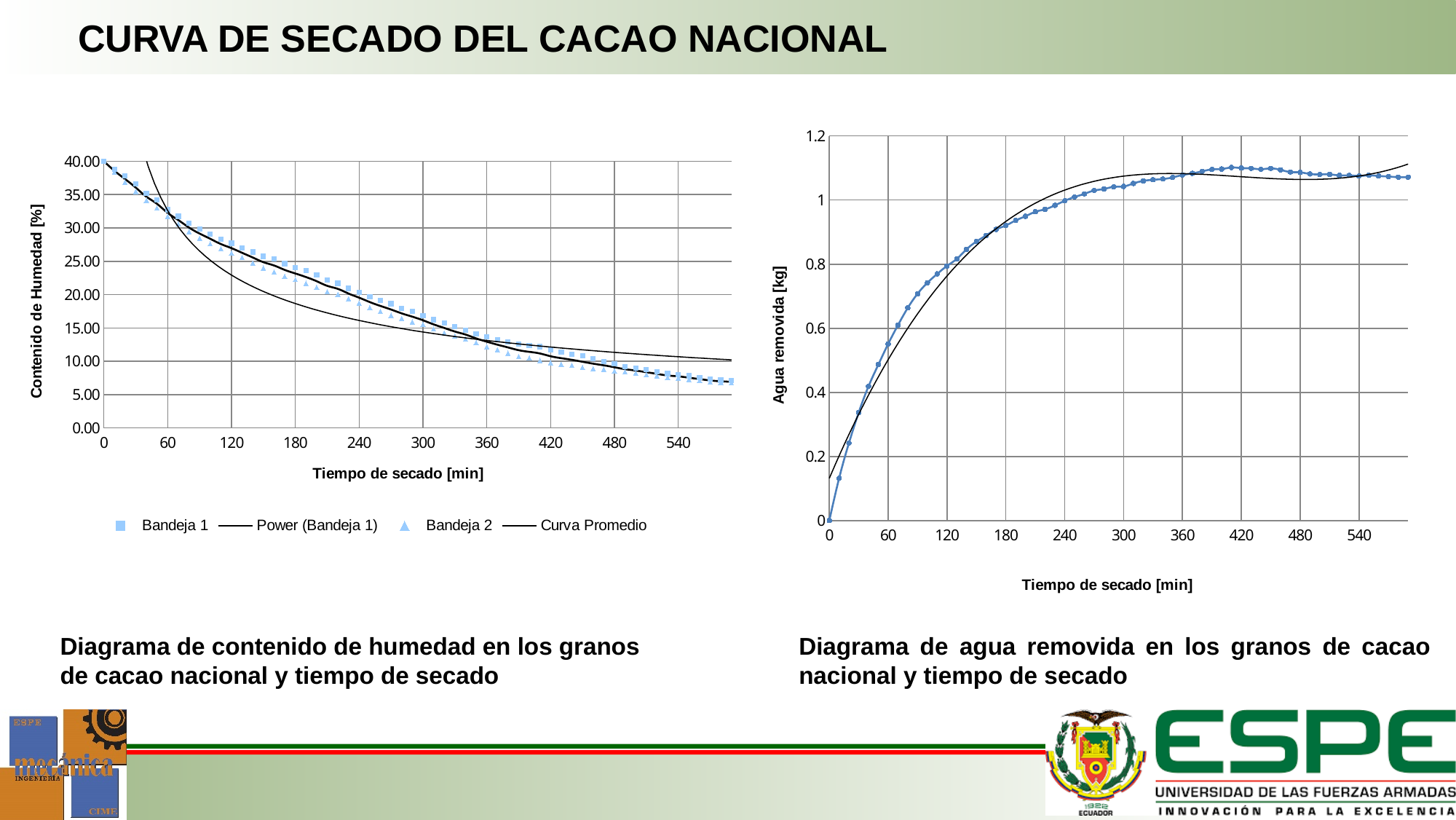
In the right chart (Agua removida), do the values rise or fall as drying time increases? rise In the right chart, what is the water removed at 0 min? 0 What is the y-axis label of the right chart? Agua removida [kg] In the right chart, is the water removed at 300 min greater or less than 1? greater In the right chart, is the water removed at 60 min greater or less than 0.4? greater What kind of chart is the left chart (Contenido de Humedad vs Tiempo de secado)? line chart In the left chart, which is larger: the moisture content at 60 min or at 360 min? 60 min In the left chart, is the moisture content at 300 min greater or less than 20.00? less What is the name of the last series listed in the legend of the left chart? Curva Promedio How many series does the legend of the left chart list? 4 In the left chart, do the moisture content values rise or fall as drying time increases? fall